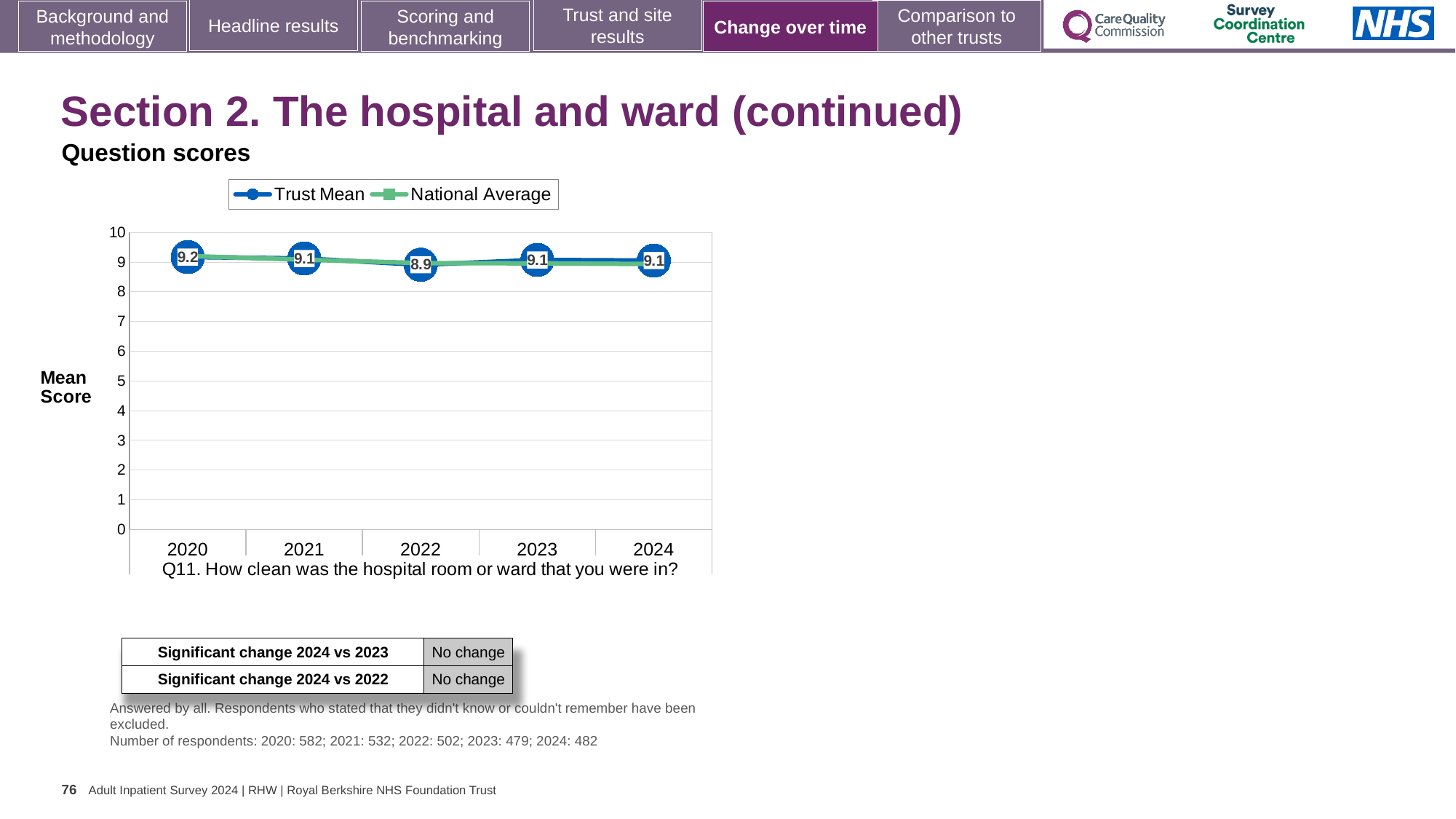
In which year is the Trust Mean lowest? 2022 How many years are plotted on the x axis? 5 What is the Trust Mean value for 2024? 9.1 What is the Trust Mean value for 2020? 9.2 Is the National Average value for 2022 greater or less than 8? greater Which is larger, the Trust Mean for 2020 or for 2022? 2020 What kind of chart is shown? Line chart Does the Trust Mean rise or fall from 2020 to 2022? Fall How many series does the legend list? 2 What is the Trust Mean value for 2022? 8.9 In which year is the Trust Mean highest? 2020 What is the difference between the Trust Mean in 2020 and in 2022? 0.3